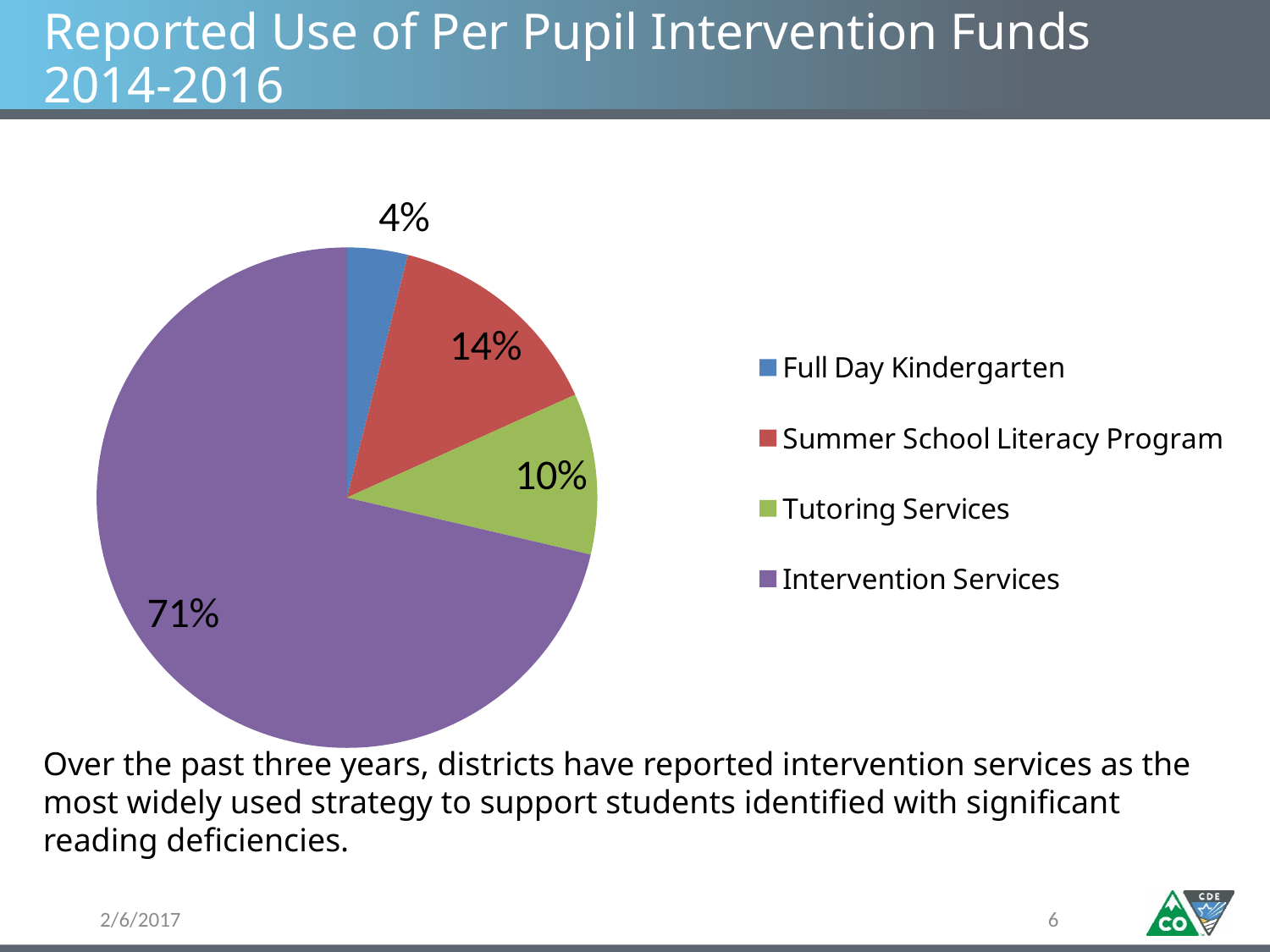
What colour is the slice for Intervention Services? purple What is the difference in percentage points between Summer School Literacy Program and Tutoring Services? 4 What share of the pie is Summer School Literacy Program? 14% Which category has the largest slice of the pie? Intervention Services What share of the pie is Tutoring Services? 10% How many categories does the pie chart show? 4 Which category has the smallest slice of the pie? Full Day Kindergarten What is the difference in percentage points between Intervention Services and Summer School Literacy Program? 57 What kind of chart is shown on the slide? pie chart Which is larger, the share for Tutoring Services or the share for Full Day Kindergarten? Tutoring Services What share of the pie is Full Day Kindergarten? 4%